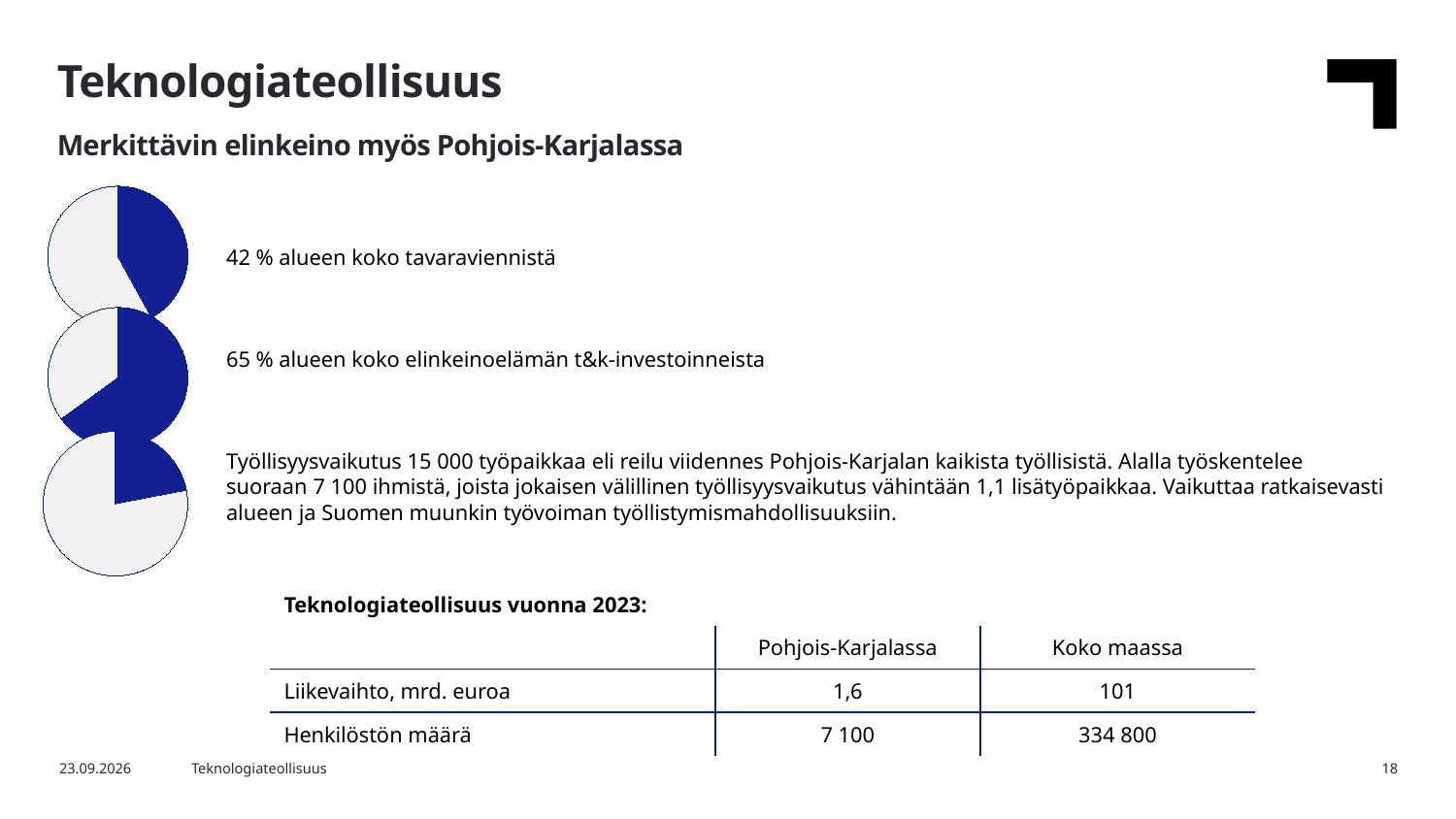
Is the highlighted slice larger in the top pie chart (tavaravienti) or the middle pie chart (t&k-investoinnit)? Middle pie chart (t&k-investoinnit) What colour is the highlighted slice in each pie chart? Blue What does the highlighted slice in the middle pie chart refer to, according to the text next to it? 65 % alueen koko elinkeinoelämän t&k-investoinneista In the bottom pie chart, is the highlighted slice greater or less than 50 %? less What kind of charts are shown on the left side of the slide? Pie charts In the top pie chart, is the highlighted slice greater or less than 50 %? less How many pie charts are on the slide? 3 In the top pie chart, what share of the region's total goods exports (tavaravienti) does the highlighted slice represent? 42 % Which pie chart has the smallest highlighted slice: the top, middle or bottom one? Bottom In the middle pie chart, what share of the region's business R&D investments (t&k-investoinnit) does the highlighted slice represent? 65 % What is the difference in percentage points between the highlighted share in the middle pie chart and the top pie chart? 23 percentage points Which pie chart has the largest highlighted slice: the top, middle or bottom one? Middle